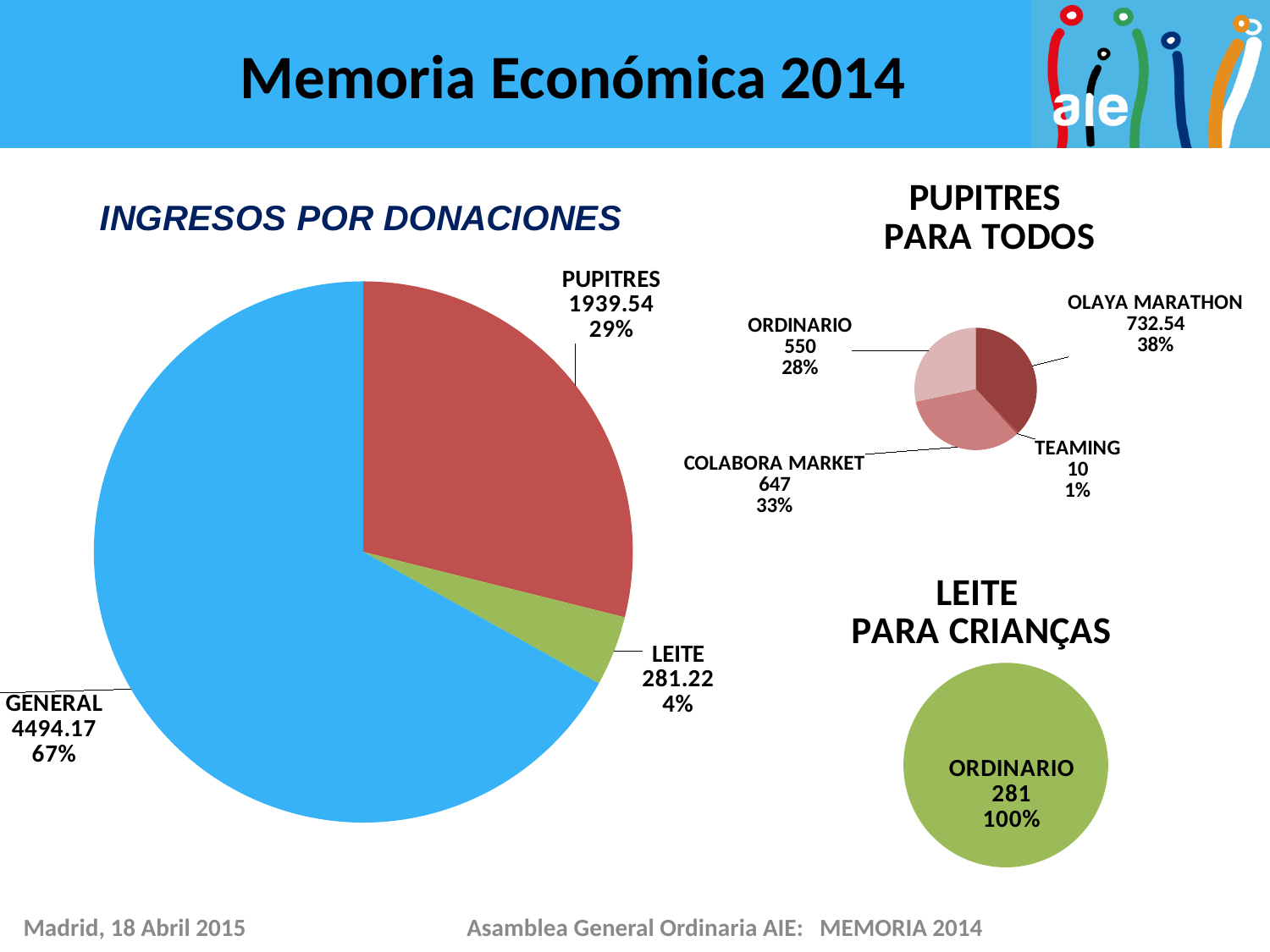
What kind of chart is INGRESOS POR DONACIONES? Pie chart In the INGRESOS POR DONACIONES chart, which category is the smallest? LEITE In the INGRESOS POR DONACIONES chart, what is the difference between the GENERAL and PUPITRES values? 2554.63 In the LEITE PARA CRIANÇAS chart, what is the value for ORDINARIO? 281 In the INGRESOS POR DONACIONES chart, what share of the pie does PUPITRES represent? 29% In the PUPITRES PARA TODOS chart, what is the value for COLABORA MARKET? 647 In the INGRESOS POR DONACIONES chart, what is the value for GENERAL? 4494.17 How many pie charts are shown on the slide? 3 How many categories are shown in the PUPITRES PARA TODOS chart? 4 In the PUPITRES PARA TODOS chart, which category is the largest? OLAYA MARATHON In the PUPITRES PARA TODOS chart, which is larger, ORDINARIO or COLABORA MARKET? COLABORA MARKET In the PUPITRES PARA TODOS chart, what share of the pie does TEAMING represent? 1%